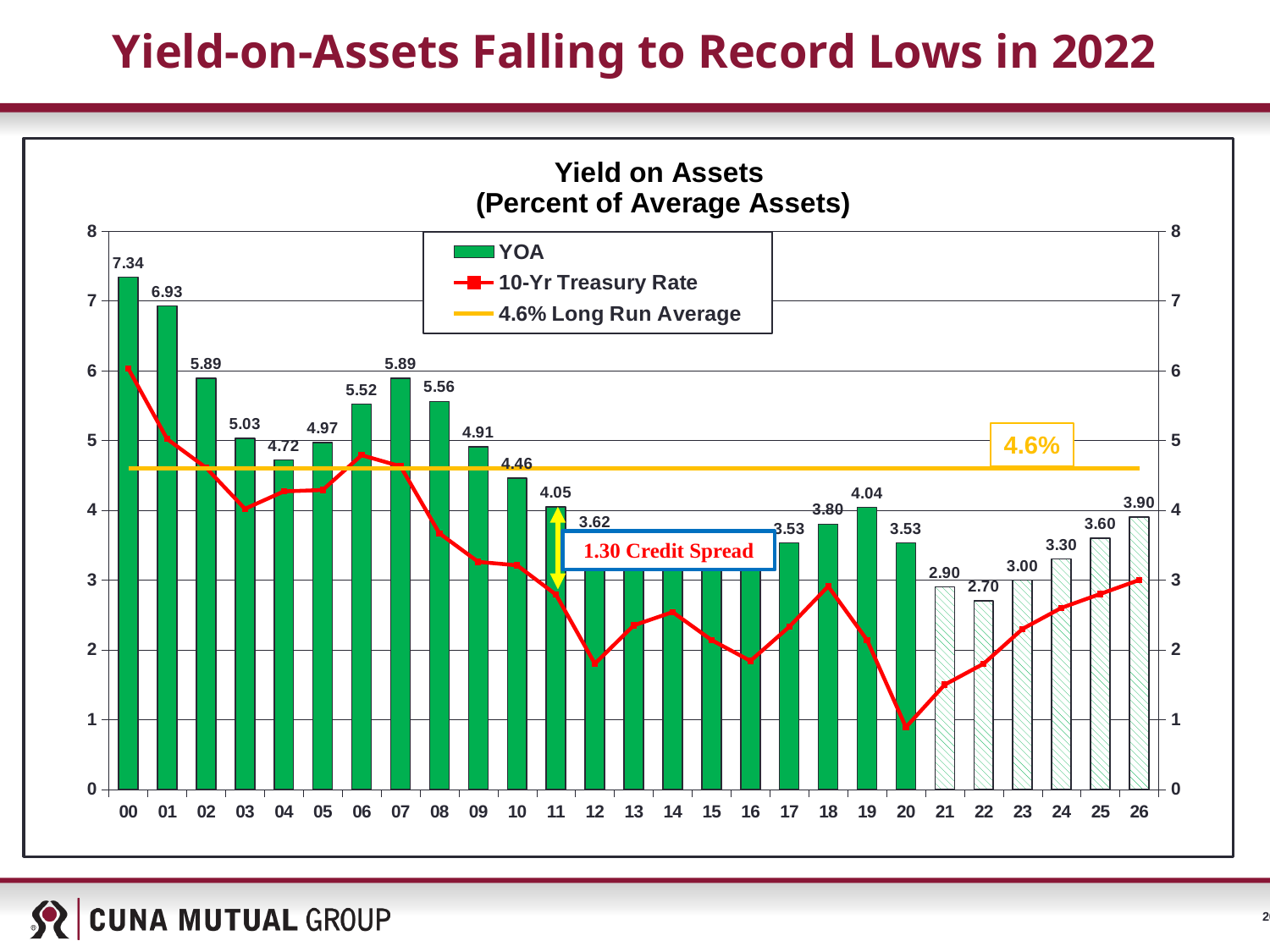
What is the difference between the YOA values for 26 and 21? 1.00 What is the YOA value for 19? 4.04 Which year has the highest YOA? 00 What is the YOA value for 22? 2.70 What is the YOA value for 00? 7.34 How many years are shown on the x axis? 27 Do the YOA values rise or fall from 21 to 26? rise Which year has the lowest YOA? 22 What is the difference between the YOA values for 00 and 01? 0.41 How many series does the legend list? 3 Which year has the larger YOA, 06 or 08? 08 Is the 10-Yr Treasury Rate for 12 greater or less than 2? less